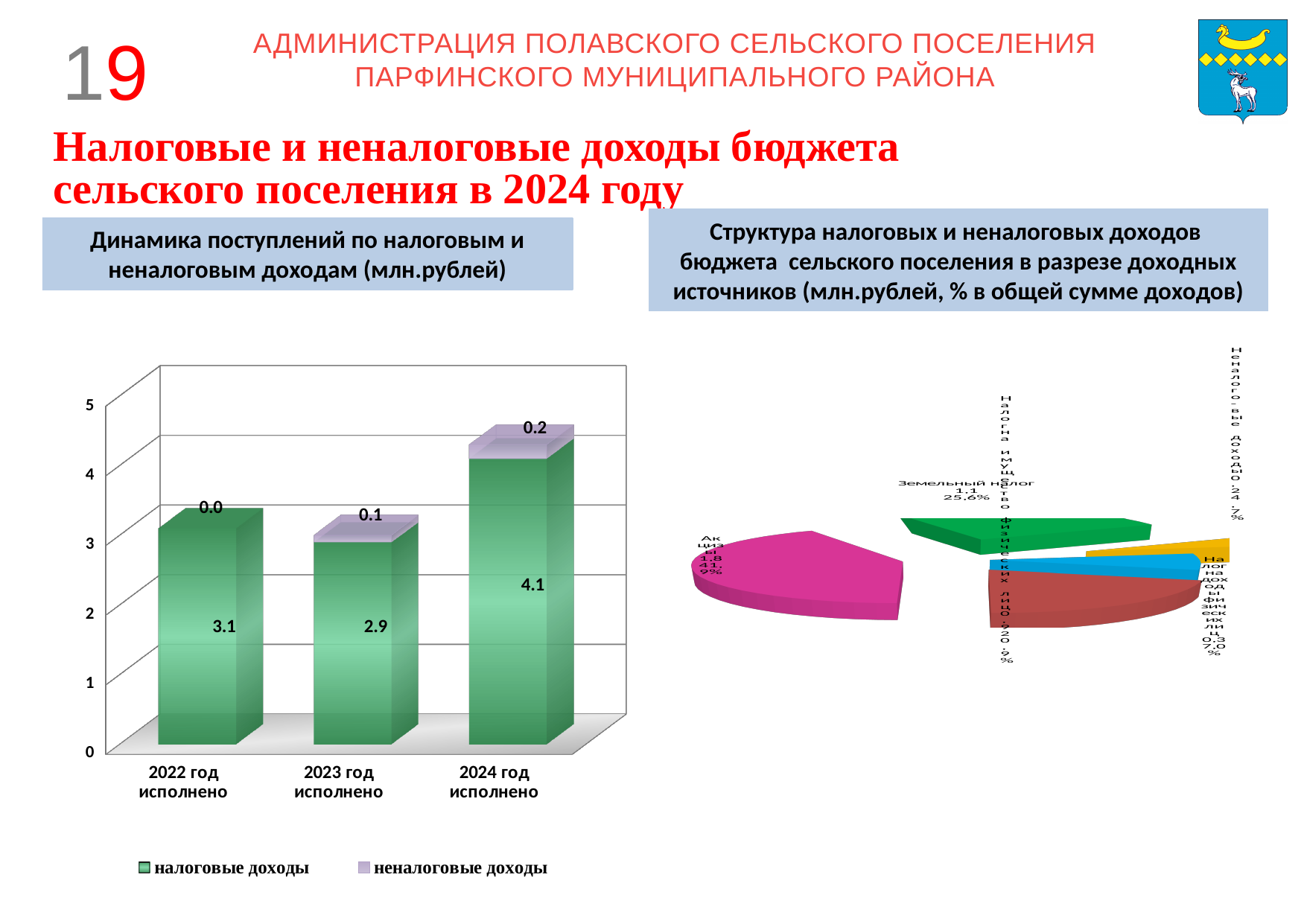
In the left chart, what is the value of неналоговые доходы for 2023 год исполнено? 0.1 In the left chart (Динамика поступлений по налоговым и неналоговым доходам), what is the value of налоговые доходы for 2024 год исполнено? 4.1 In the left chart, what is the value of налоговые доходы for 2022 год исполнено? 3.1 What kind of chart is the right chart? Pie chart In the left chart, how many series does the legend list? 2 What kind of chart is the left chart? Bar chart In the left chart, what is the total of the stacked bar for 2024 год исполнено? 4.3 In the left chart, how many categories are shown on the x axis? 3 In the left chart, which year has the highest налоговые доходы? 2024 год исполнено In the right chart (Структура налоговых и неналоговых доходов), what share of total income does Земельный налог represent? 25.6% In the left chart, what is the difference in налоговые доходы between 2024 год исполнено and 2023 год исполнено? 1.2 In the left chart, which year has the lowest налоговые доходы? 2023 год исполнено